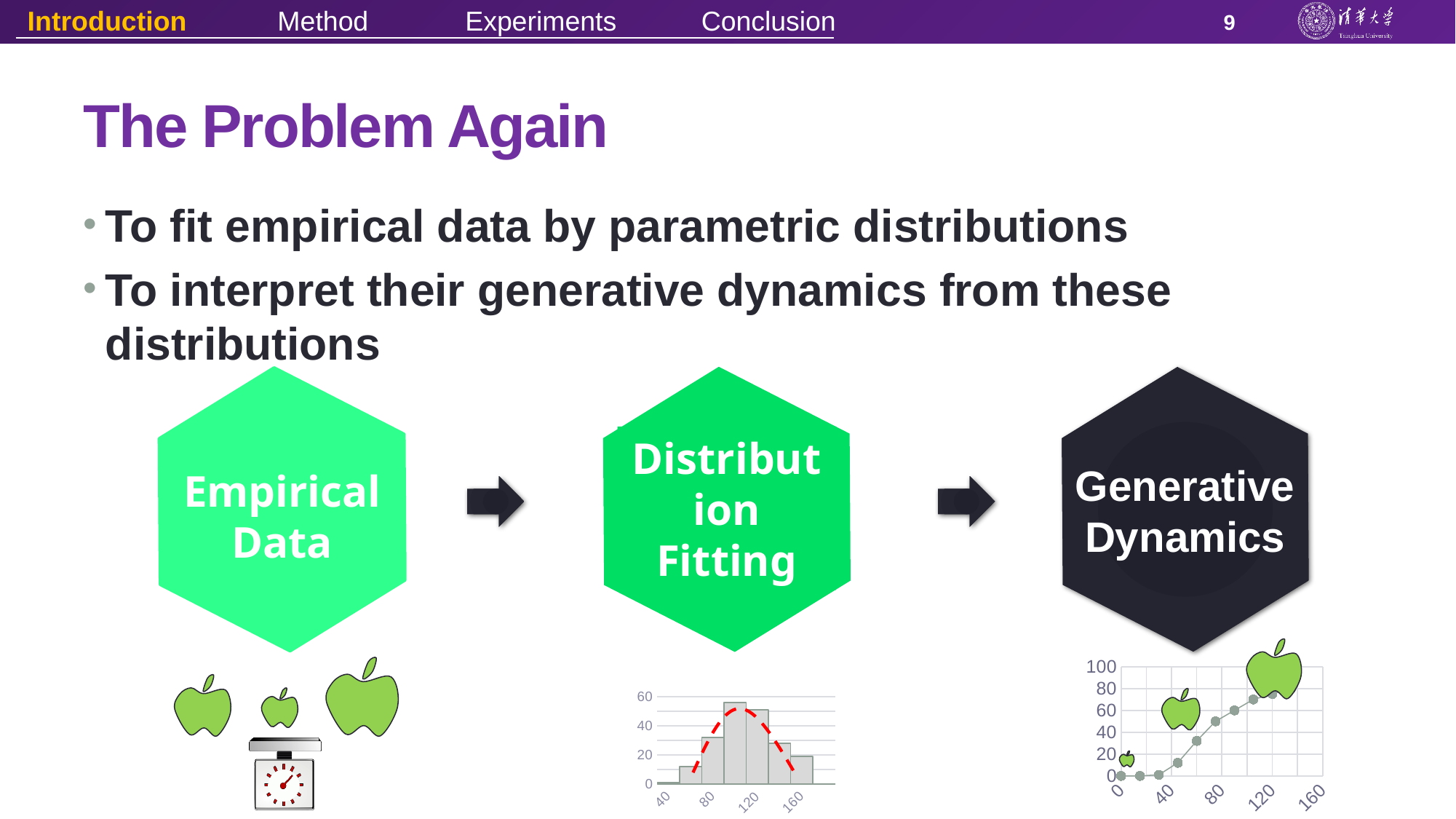
What is the highest y-axis tick shown on the line chart below 'Generative Dynamics'? 100 In the bar chart below 'Distribution Fitting', is the tallest bar greater or less than 40? greater In the line chart below 'Generative Dynamics', is the value at x = 120 greater or less than 40? greater In the line chart below 'Generative Dynamics', do the values rise or fall as x increases? rise In the line chart below 'Generative Dynamics', is the value at x = 40 greater or less than 20? less In the line chart below 'Generative Dynamics', what is the value at x = 0? 0 What is the highest y-axis tick shown on the bar chart below 'Distribution Fitting'? 60 What kind of chart is shown below the 'Generative Dynamics' hexagon? line chart What kind of chart is shown below the 'Distribution Fitting' hexagon? bar chart